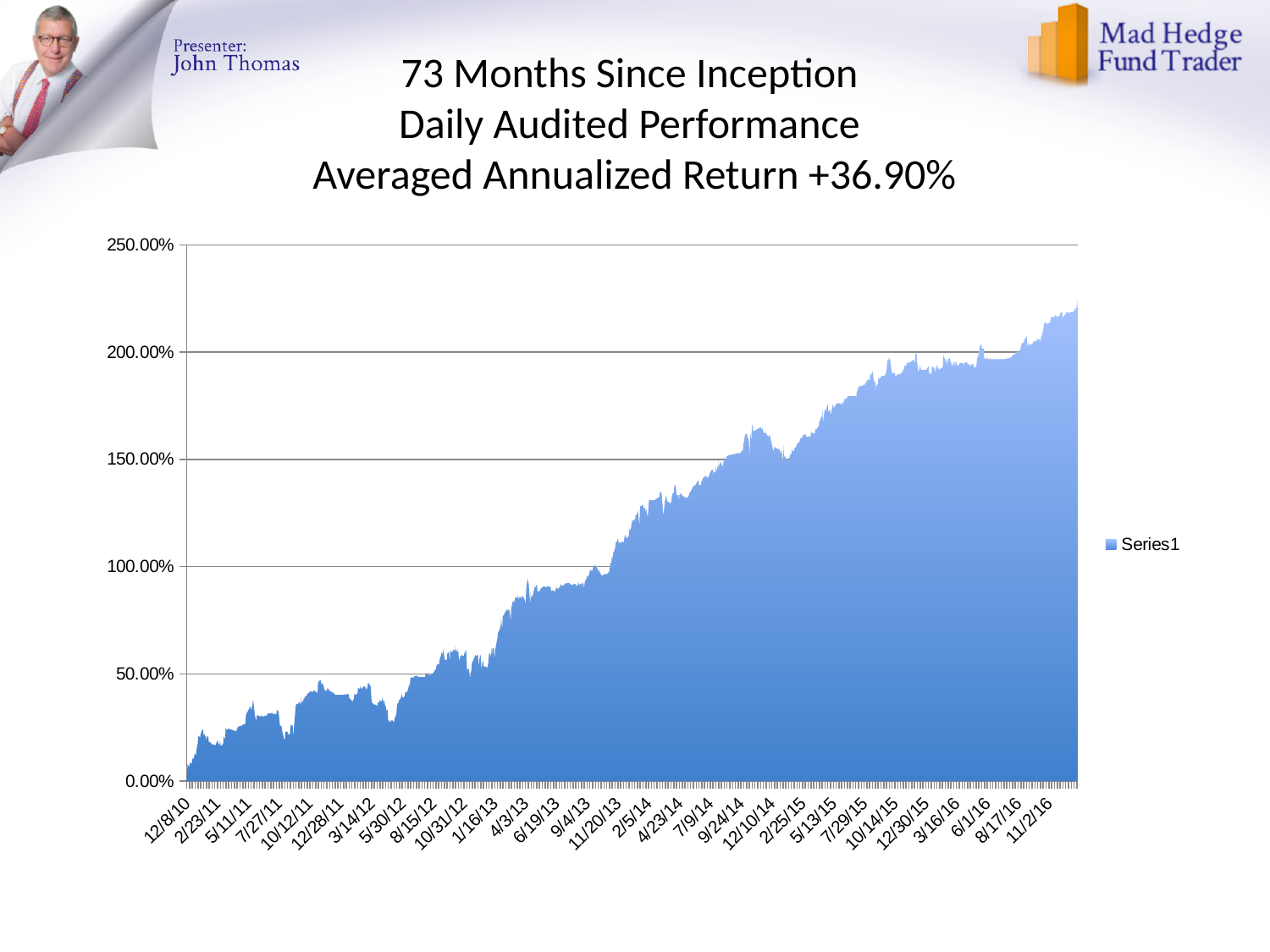
Is the value at 11/2/16 greater or less than 200.00%? greater Which is larger, the value at 11/2/16 or the value at 12/8/10? 11/2/16 Do the values generally rise or fall from left to right along the x axis? rise How many series does the legend list? 1 Is the value at 2/5/14 greater or less than 100.00%? greater Is the value at 6/19/13 greater or less than 100.00%? less What averaged annualized return is stated in the chart title? +36.90% What kind of chart is shown on the slide? area chart What is the name of the series shown in the legend? Series1